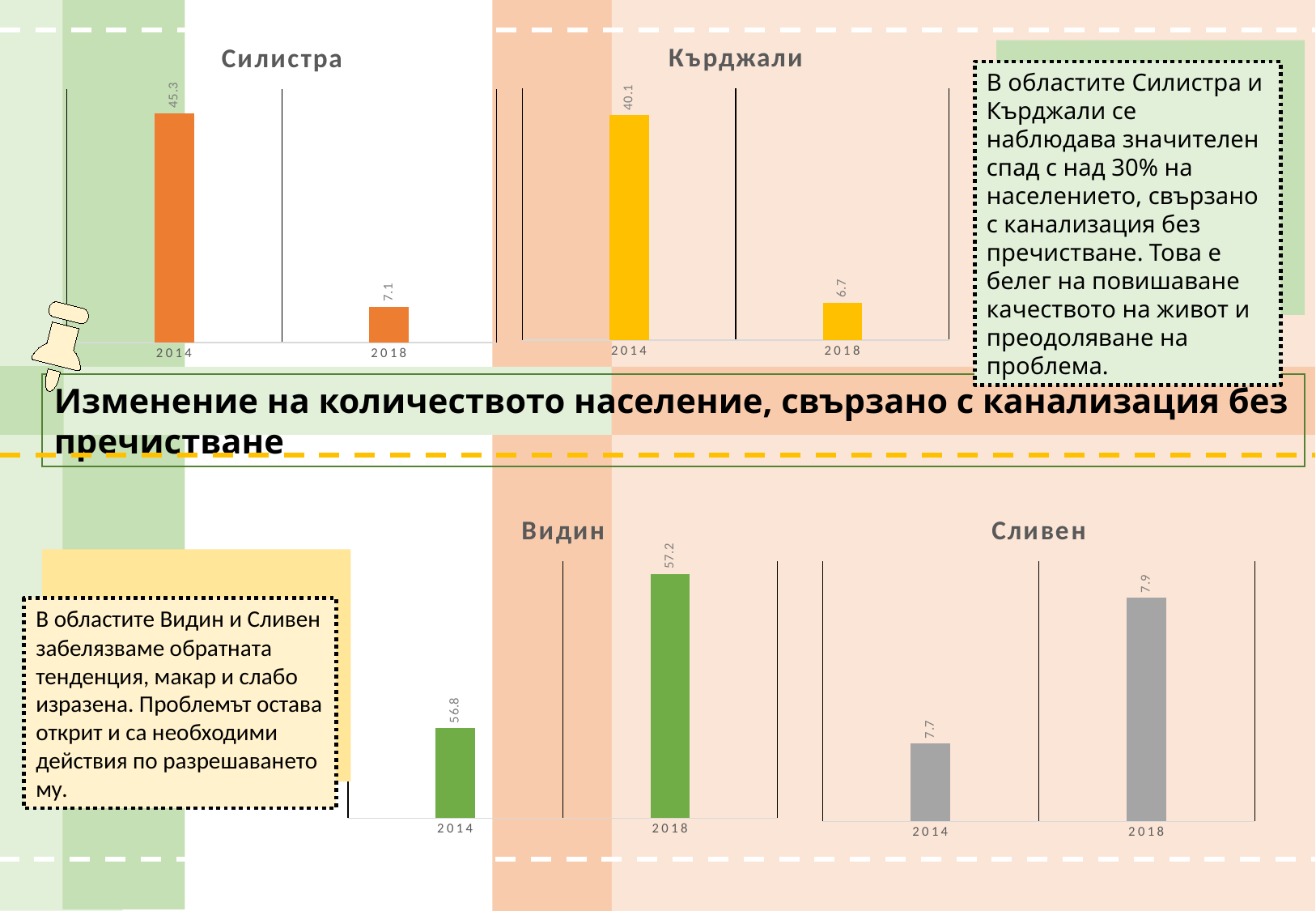
In the Силистра chart, what is the value for 2018? 7.1 In the Силистра chart, which year has the higher value, 2014 or 2018? 2014 In the Сливен chart, how many bars are plotted? 2 In the Силистра chart, what is the difference between the 2014 and 2018 values? 38.2 In the Сливен chart, what is the value for 2014? 7.7 In the Видин chart, do the values rise or fall from 2014 to 2018? rise In the Видин chart, what is the value for 2018? 57.2 What type of chart is the Кърджали chart? bar chart In the Силистра chart, what is the value for 2014? 45.3 In the Кърджали chart, what is the value for 2018? 6.7 In the Кърджали chart, what is the difference between the 2014 and 2018 values? 33.4 In the Кърджали chart, what is the value for 2014? 40.1